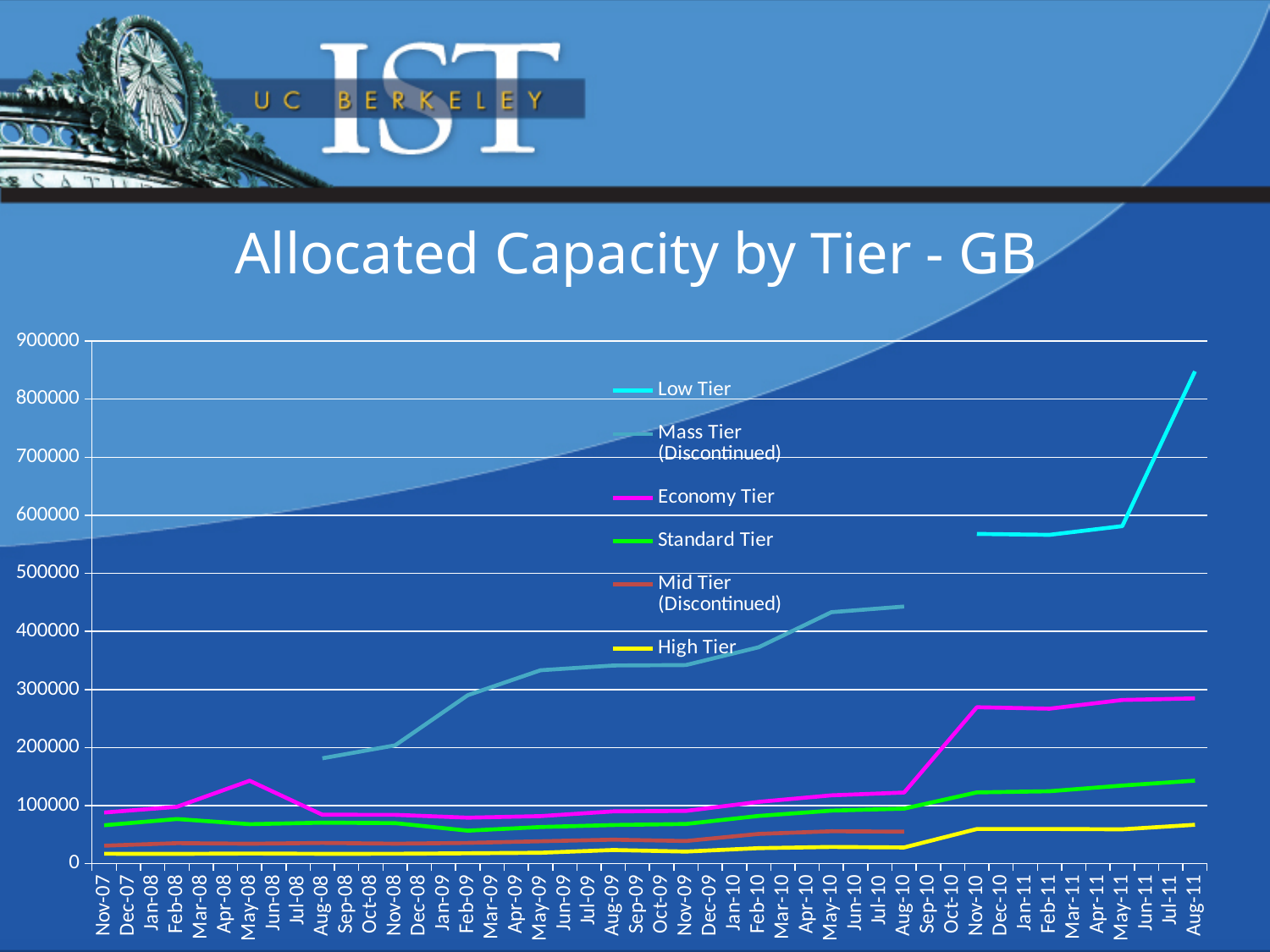
Which series is plotted in yellow? High Tier How many months are shown along the x axis? 46 What kind of chart is shown on the slide? line chart Is the value for Low Tier in Aug-11 greater or less than 800000? greater What is the title of the chart? Allocated Capacity by Tier - GB Is the value for Low Tier in Nov-10 greater or less than 600000? less Is the value for Standard Tier in Aug-11 greater or less than 100000? greater Does the Low Tier line rise or fall from Nov-10 to Aug-11? rise How many series does the legend list? 6 Which series has the lowest value in Aug-11? High Tier Which series has the highest value in Aug-11? Low Tier